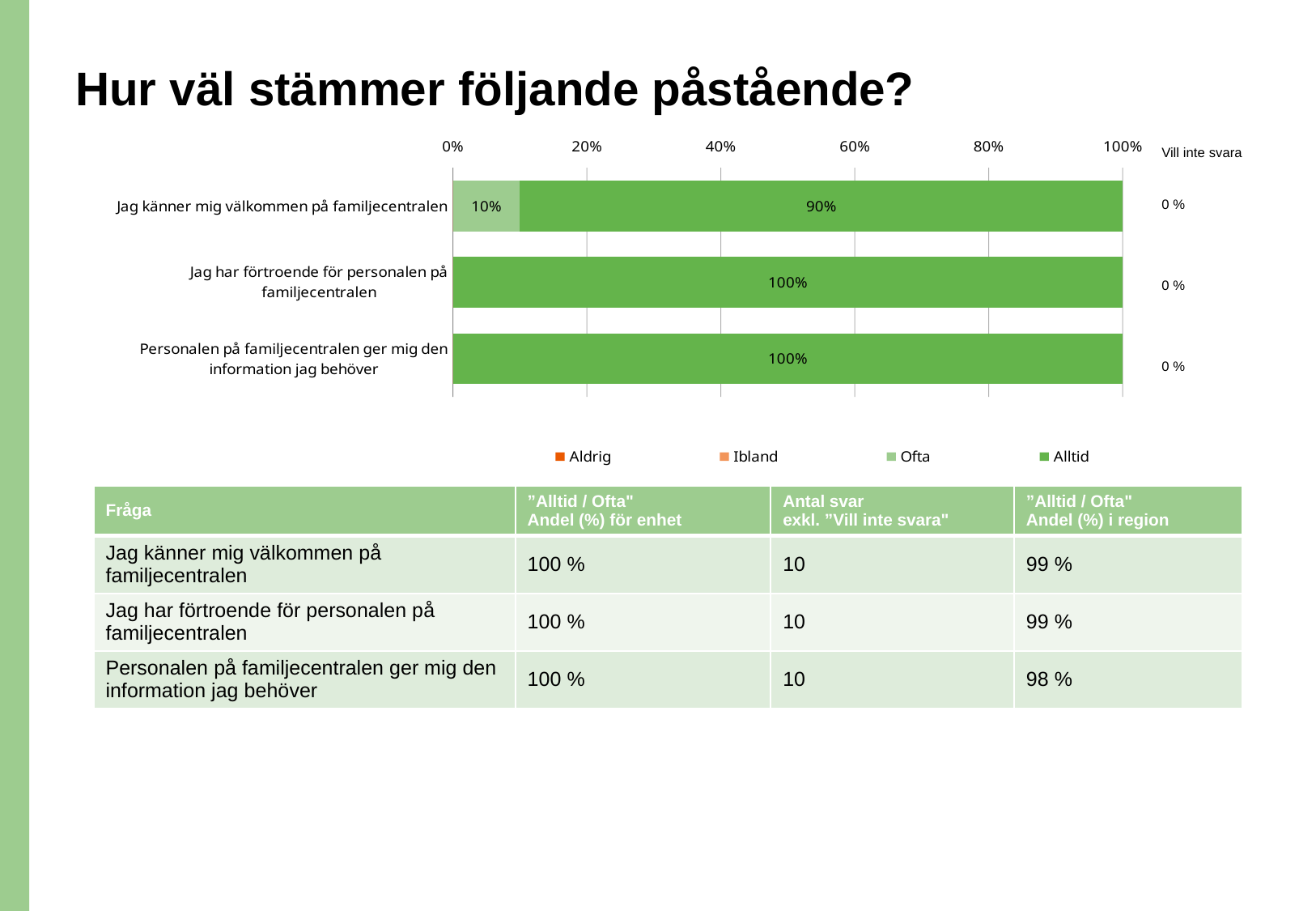
Which statement has the lowest "Alltid" value? Jag känner mig välkommen på familjecentralen What kind of chart is shown on the slide? bar chart What is the "Alltid" value for "Jag känner mig välkommen på familjecentralen"? 90% What is the "Alltid" value for "Jag har förtroende för personalen på familjecentralen"? 100% What is the "Alltid" value for "Personalen på familjecentralen ger mig den information jag behöver"? 100% What is the "Vill inte svara" value shown for "Personalen på familjecentralen ger mig den information jag behöver"? 0 % What are the four legend entries of the chart? Aldrig, Ibland, Ofta, Alltid How many statements (categories) are plotted in the chart? 3 What is the "Ofta" value for "Jag känner mig välkommen på familjecentralen"? 10% How many series does the chart legend list? 4 What is the difference between the "Alltid" and "Ofta" values for "Jag känner mig välkommen på familjecentralen"? 80% Is the "Alltid" value for "Jag känner mig välkommen på familjecentralen" larger or smaller than the "Alltid" value for "Jag har förtroende för personalen på familjecentralen"? smaller